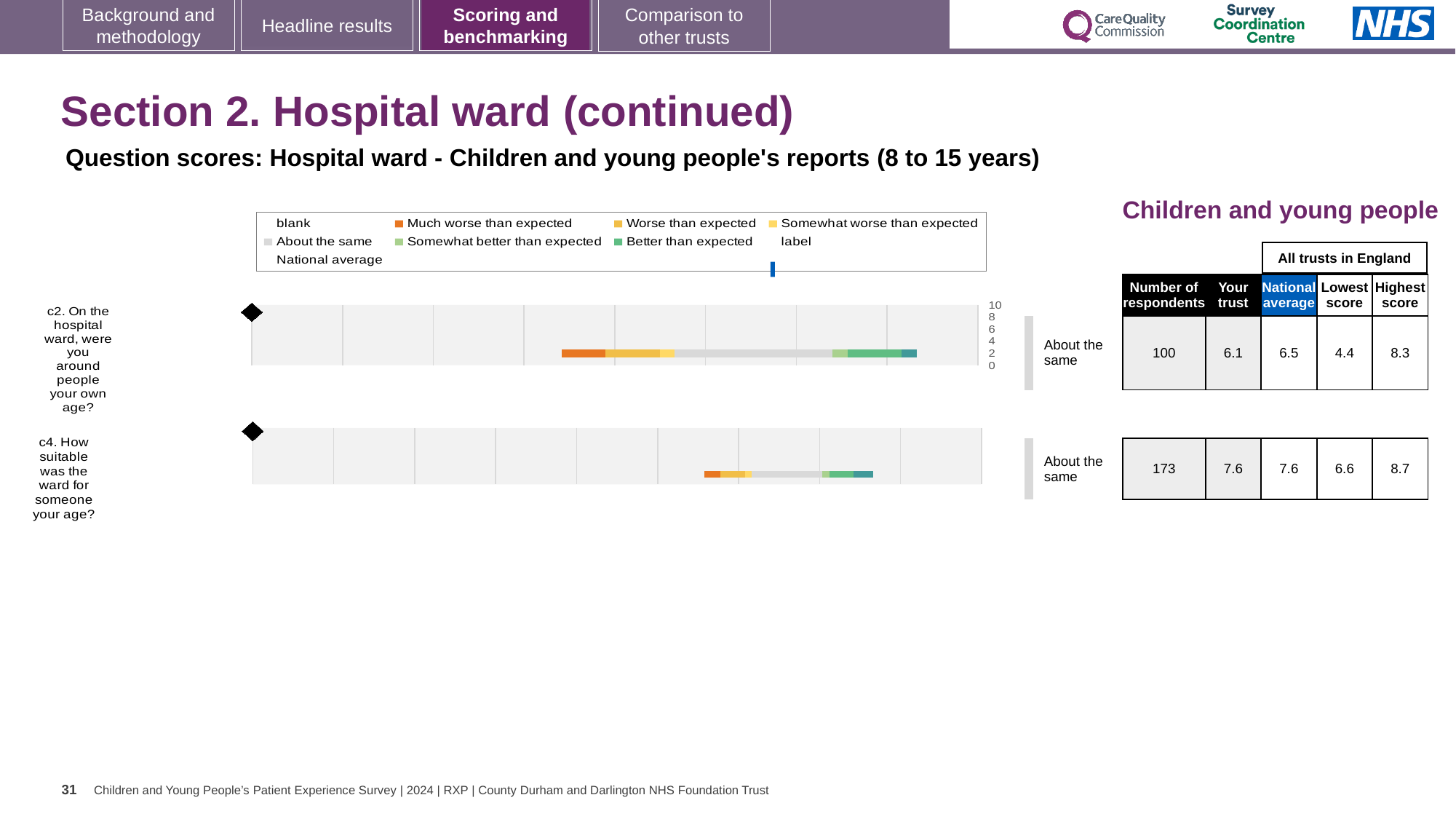
What kind of chart is used to show the question scores on this slide? bar chart How many respondents answered question c2? 100 What benchmark category is given for question c4? About the same How many survey questions are plotted on the slide? 2 What is the difference between the highest and lowest scores for question c2? 3.9 By how much does the national average exceed the trust's score for question c2? 0.4 What is the national average score for question c4 (How suitable was the ward for someone your age?)? 7.6 Which question has the higher 'Your trust' score, c2 or c4? c4 Which question has more respondents, c2 or c4? c4 What is the lowest score among all trusts in England for question c4? 6.6 What is the 'Your trust' score for question c2 (On the hospital ward, were you around people your own age?)? 6.1 Which legend entry is shown in orange? Much worse than expected